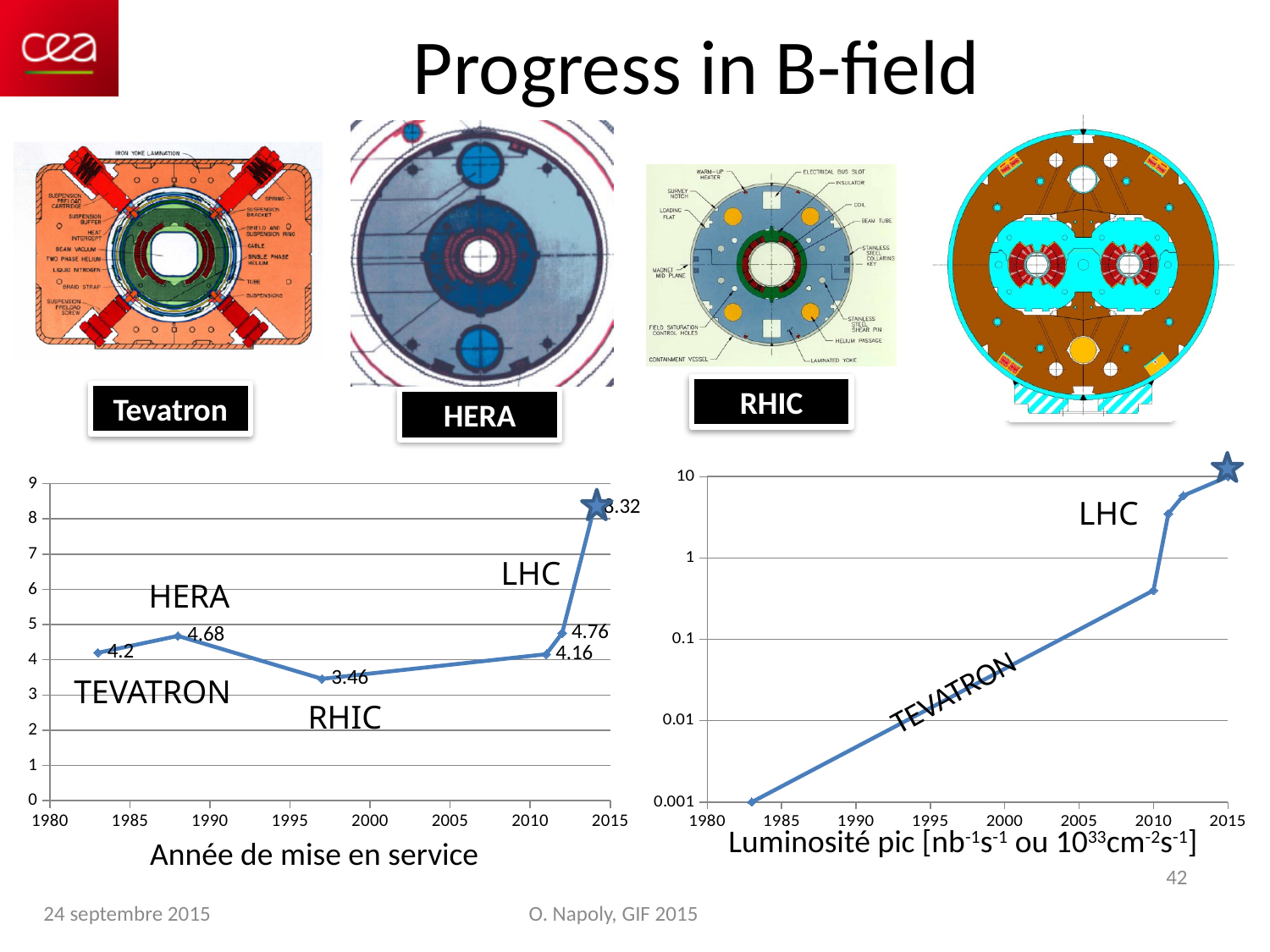
In the left chart (Année de mise en service), what is the difference between the HERA value (4.68) and the RHIC value (3.46)? 1.22 In the right chart (Luminosité pic), do the values rise or fall from 1980 to 2015? rise In the right chart (Luminosité pic), is the value plotted at 2010 greater or less than 1? less In the left chart (Année de mise en service), what is the value labelled for HERA? 4.68 What is the x-axis title of the left chart? Année de mise en service In the left chart (Année de mise en service), which is larger: the TEVATRON value or the HERA value? HERA In the left chart (Année de mise en service), how many data points are plotted? 6 In the left chart (Année de mise en service), what is the highest labelled value? 8.32 What kind of chart is the left chart (Année de mise en service)? line chart In the left chart (Année de mise en service), what is the value labelled for TEVATRON? 4.2 In the left chart (Année de mise en service), which accelerator has the lowest labelled value? RHIC In the left chart (Année de mise en service), what is the value labelled for RHIC? 3.46